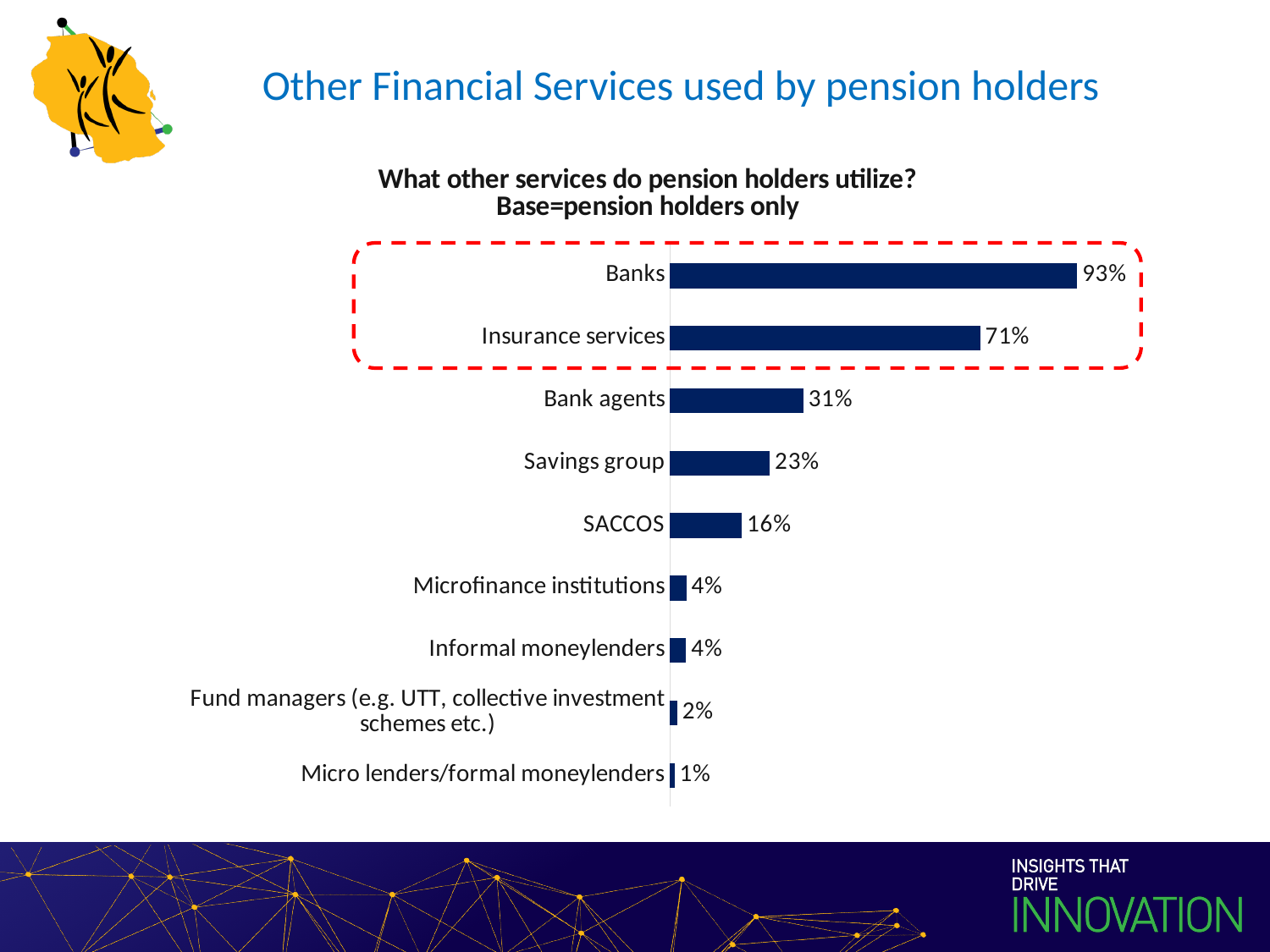
What is the value shown for Savings group? 23% What is the value shown for SACCOS? 16% Which service has the highest share of pension holders using it? Banks How many categories are shown in the chart? 9 What is the difference between the values for Banks and Insurance services? 22% What percentage of pension holders use banks? 93% Which service has the lowest share of pension holders using it? Micro lenders/formal moneylenders Which two categories are enclosed by the red dashed box? Banks and Insurance services What kind of chart is shown on the slide? Bar chart Which is larger, the value for Bank agents or the value for SACCOS? Bank agents What percentage of pension holders use insurance services? 71% What is the difference between the values for Bank agents and Savings group? 8%